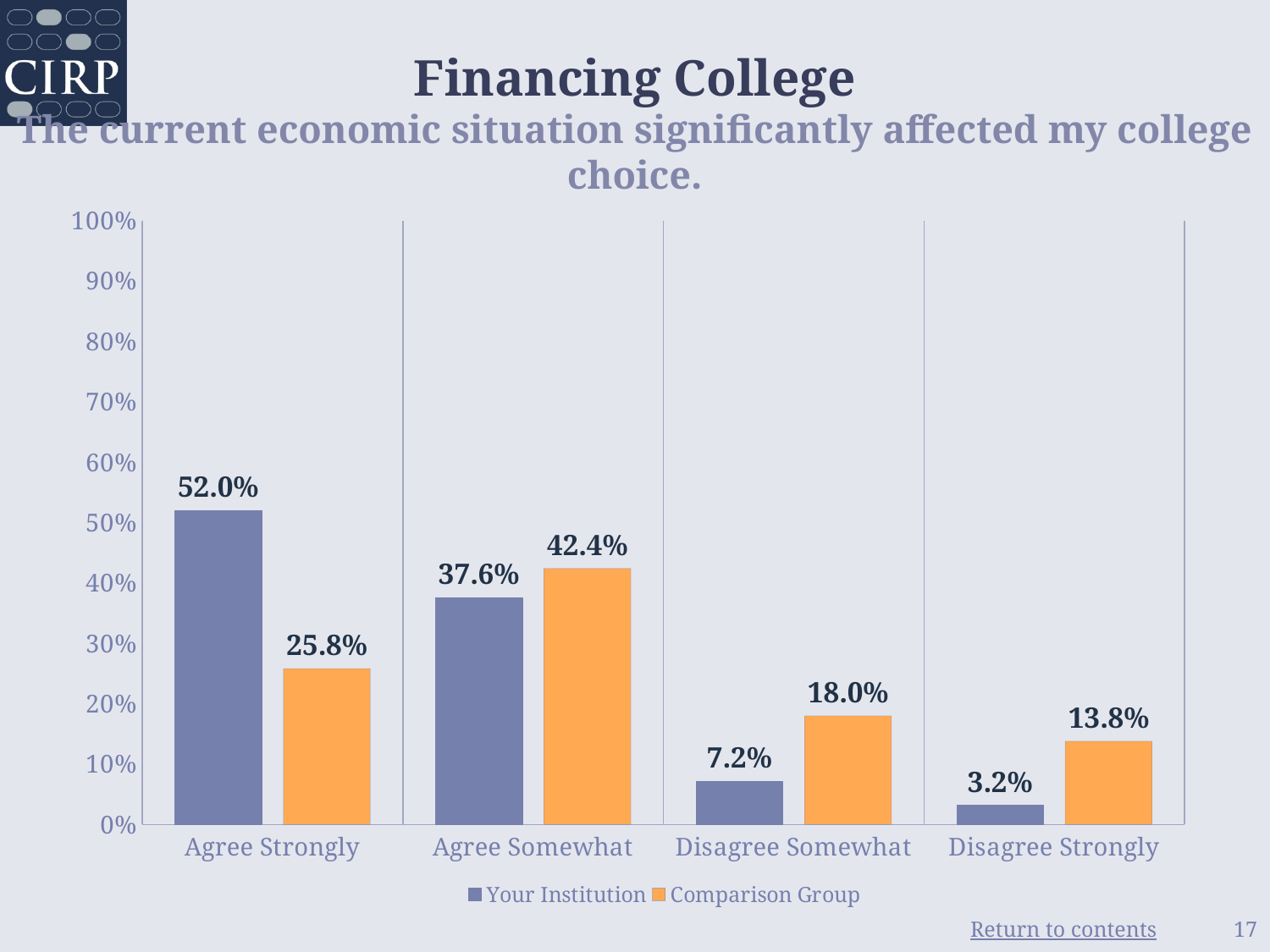
How many series does the legend list? 2 What is the difference between Your Institution and the Comparison Group for Agree Strongly? 26.2% Which response category has the lowest value for the Comparison Group? Disagree Strongly Which is larger for Disagree Somewhat: Your Institution or the Comparison Group? Comparison Group Which response category has the highest value for Your Institution? Agree Strongly Is the Comparison Group value for Agree Somewhat greater or less than 40%? greater What is the Comparison Group value for Agree Somewhat? 42.4% Which colour represents the Comparison Group in the chart? Orange How many response categories are shown on the x axis? 4 What is the Your Institution value for Disagree Strongly? 3.2% What type of chart is shown on the slide? Bar chart What percentage of Your Institution respondents chose Agree Strongly? 52.0%